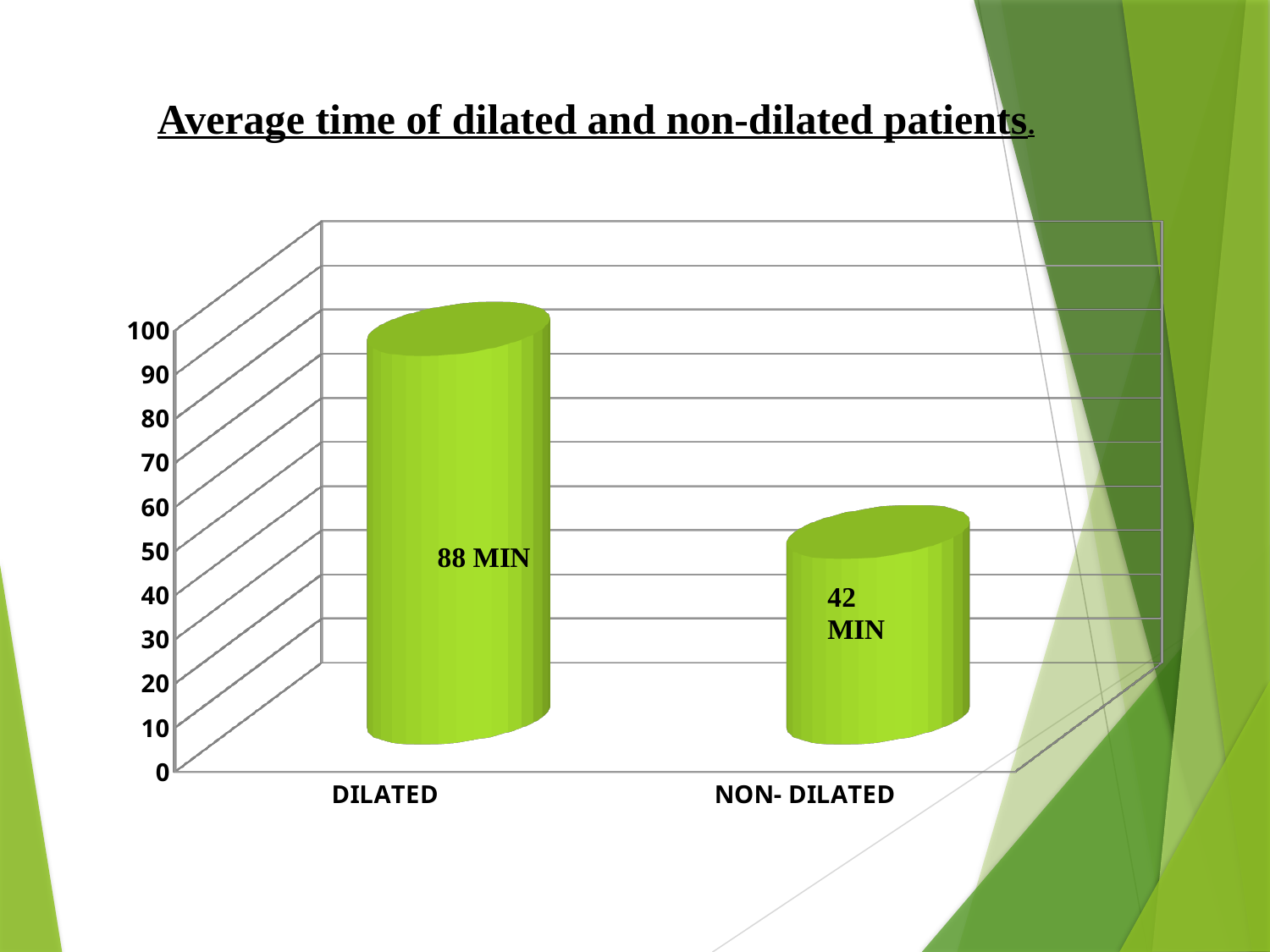
Is the value for NON- DILATED greater or less than 50? less How many categories are shown on the chart? 2 Which category has the lowest average time? NON- DILATED What is the average time for DILATED patients? 88 MIN Is the value for DILATED greater or less than 80? greater Which category has the highest average time? DILATED What is the highest value shown on the vertical axis? 100 What kind of chart is shown on the slide? bar chart What is the title of the slide? Average time of dilated and non-dilated patients. Which is larger, the average time for DILATED or NON- DILATED patients? DILATED What is the difference in average time between DILATED and NON- DILATED patients? 46 MIN What is the average time for NON- DILATED patients? 42 MIN